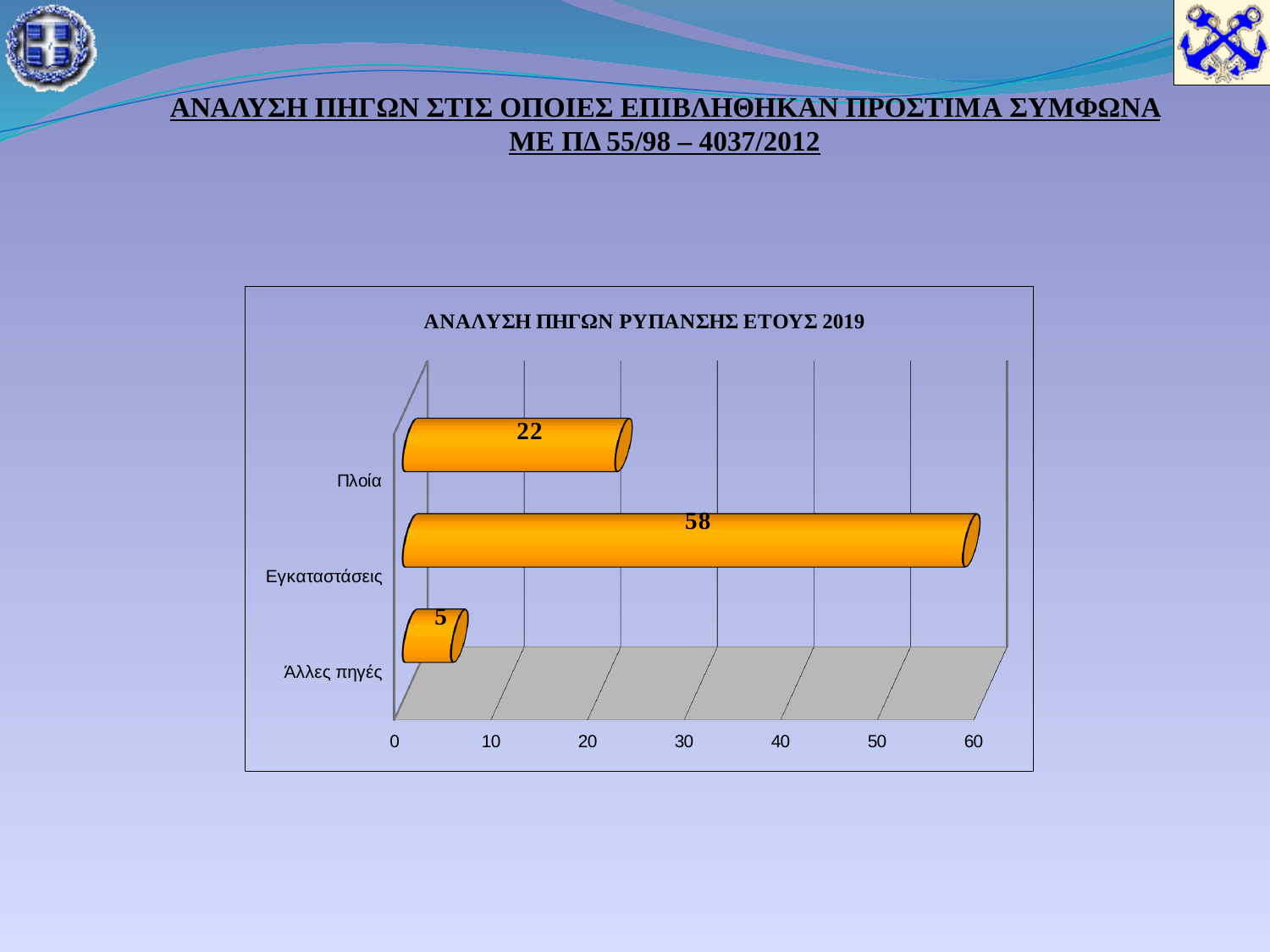
What is the value for Πλοία? 22 What is the title of the chart? ΑΝΑΛΥΣΗ ΠΗΓΩΝ ΡΥΠΑΝΣΗΣ ΕΤΟΥΣ 2019 Which category has the highest value? Εγκαταστάσεις What is the difference between the values for Πλοία and Άλλες πηγές? 17 Which category has the lowest value? Άλλες πηγές What is the value for Άλλες πηγές? 5 What is the value for Εγκαταστάσεις? 58 What kind of chart is shown on the slide? bar chart Is the value for Εγκαταστάσεις greater or less than 50? greater What is the difference between the values for Εγκαταστάσεις and Πλοία? 36 How many categories are shown in the chart? 3 Which is larger, the value for Πλοία or the value for Άλλες πηγές? Πλοία